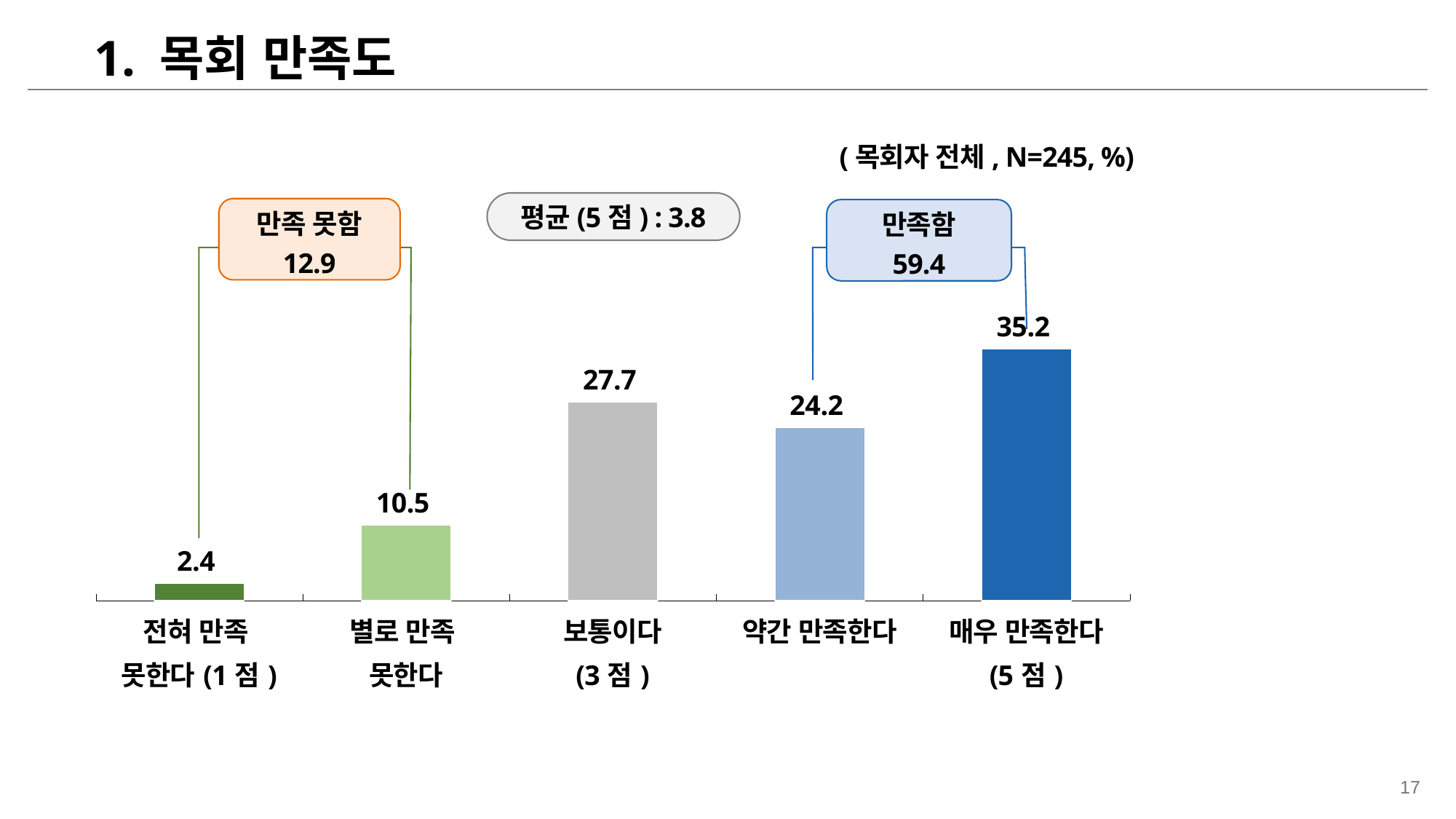
What average score (평균, 5 점) is shown on the slide? 3.8 Which category has the highest value? 매우 만족한다 (5 점) What is the value for 보통이다 (3 점)? 27.7 Which category has the lowest value? 전혀 만족 못한다 (1 점) What is the difference between the values for 매우 만족한다 and 약간 만족한다? 11.0 What kind of chart is shown on the slide? Bar chart How many categories are shown on the x axis? 5 Which is larger, the value for 보통이다 or the value for 약간 만족한다? 보통이다 What is the value for 매우 만족한다 (5 점)? 35.2 What is the value for 전혀 만족 못한다 (1 점)? 2.4 What is the combined value shown in the 만족함 callout? 59.4 What is the combined value shown in the 만족 못함 callout? 12.9